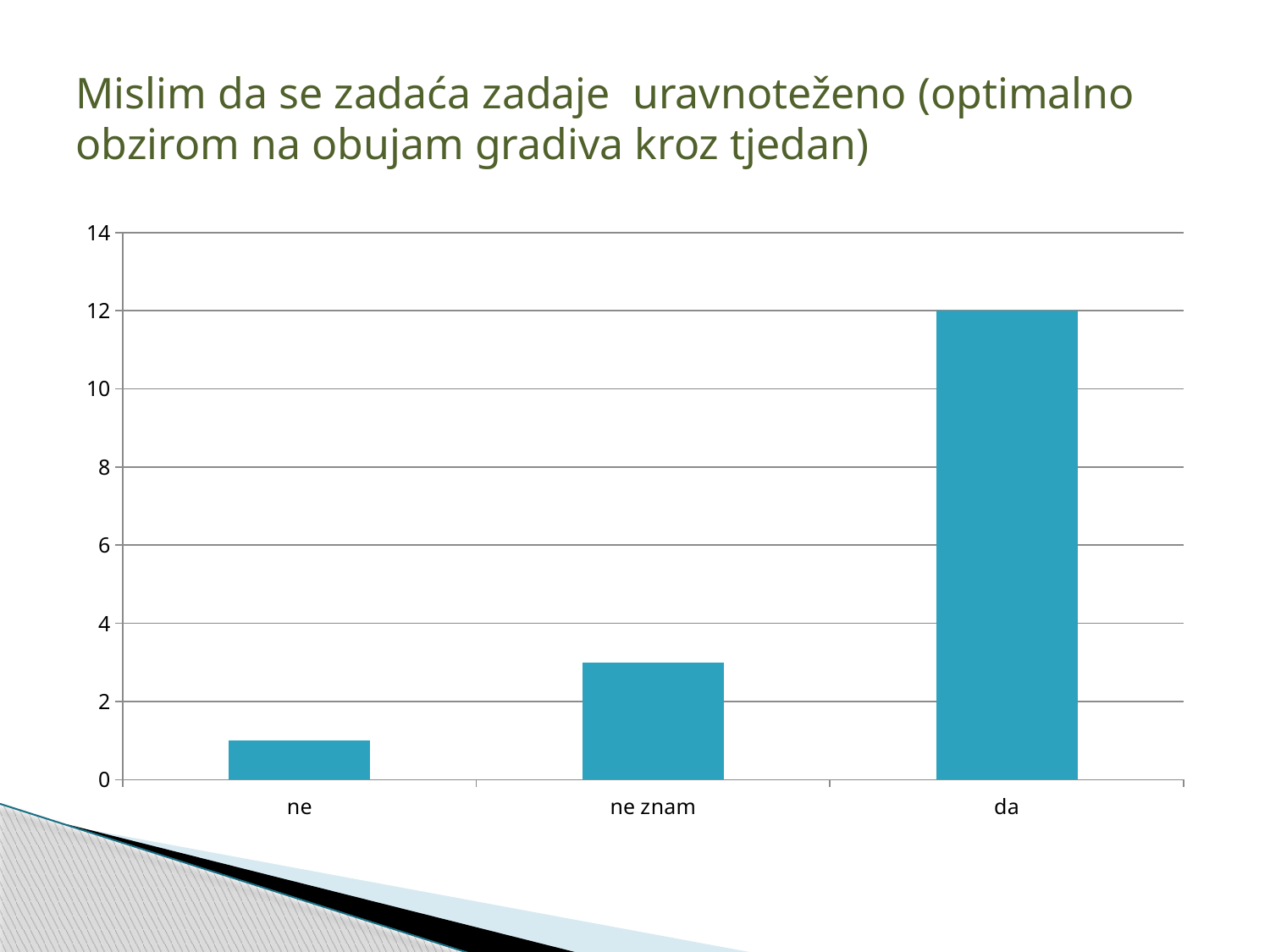
What is the value for "da"? 12 What kind of chart is shown on the slide? bar chart Is the value for "da" greater or less than 10? greater Is the value for "ne" greater or less than 2? less Do the values rise or fall from left to right along the x axis? rise Which is larger, the value for "ne znam" or the value for "da"? da Is the value for "ne znam" greater or less than 4? less What is the highest value shown on the vertical axis of the chart? 14 Which category has the highest value? da How many categories are shown on the x axis of the chart? 3 Which category has the lowest value? ne